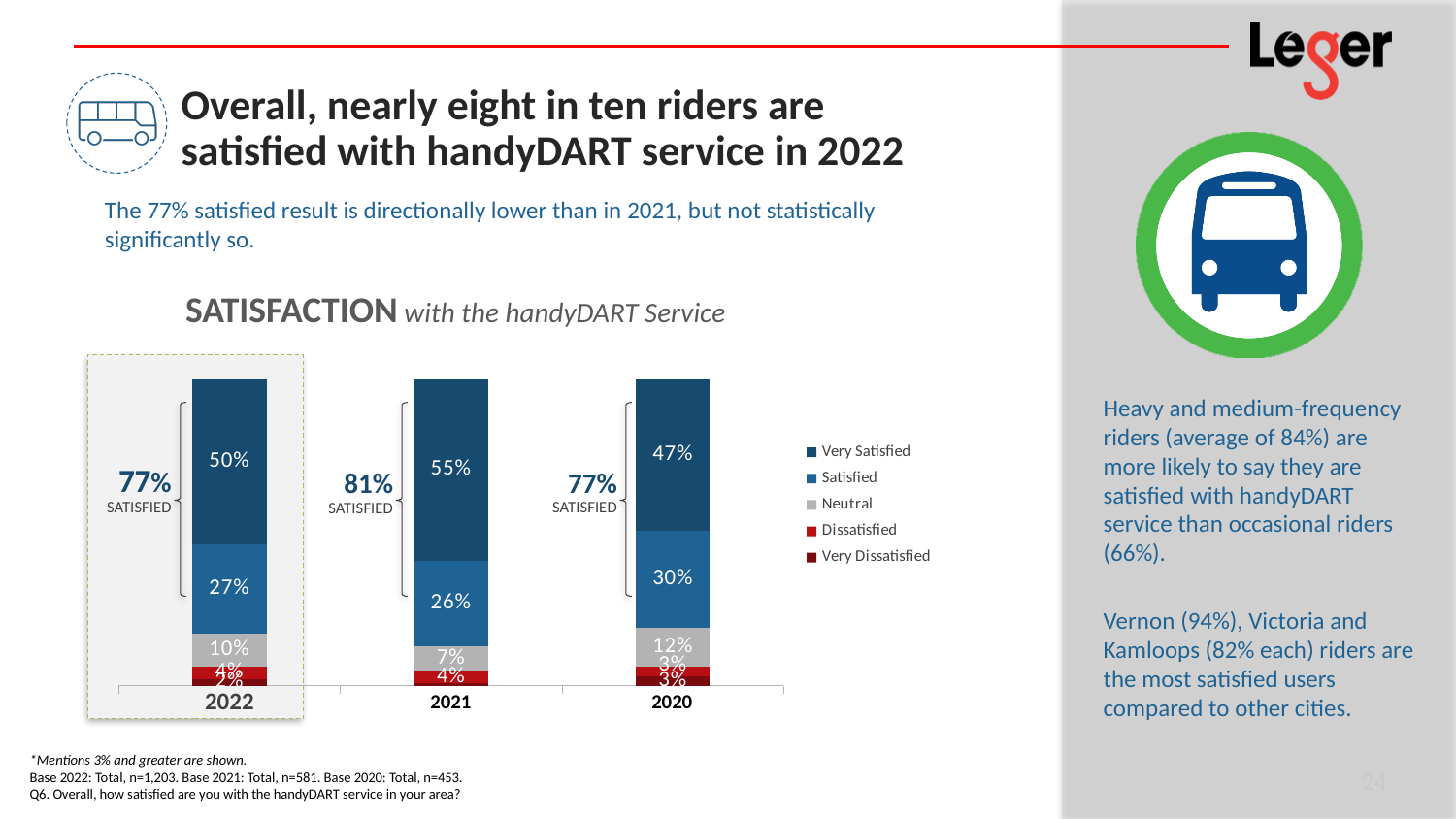
Which year has the lowest Very Satisfied percentage? 2020 How many series does the legend list? 5 How many years are shown on the x axis of the chart? 3 What is the difference between the Very Satisfied percentages for 2021 and 2020? 8 percentage points What is the Neutral value for 2022? 10% What percentage of riders were Satisfied in 2020? 30% What is the total satisfied percentage (Very Satisfied plus Satisfied) shown for 2021? 81% Which year has the highest Very Satisfied percentage? 2021 Which year has the highest Neutral percentage? 2020 What kind of chart is shown on the slide? Stacked bar chart What percentage of riders were Very Satisfied in 2021? 55% Which year has the higher Satisfied percentage, 2022 or 2021? 2022